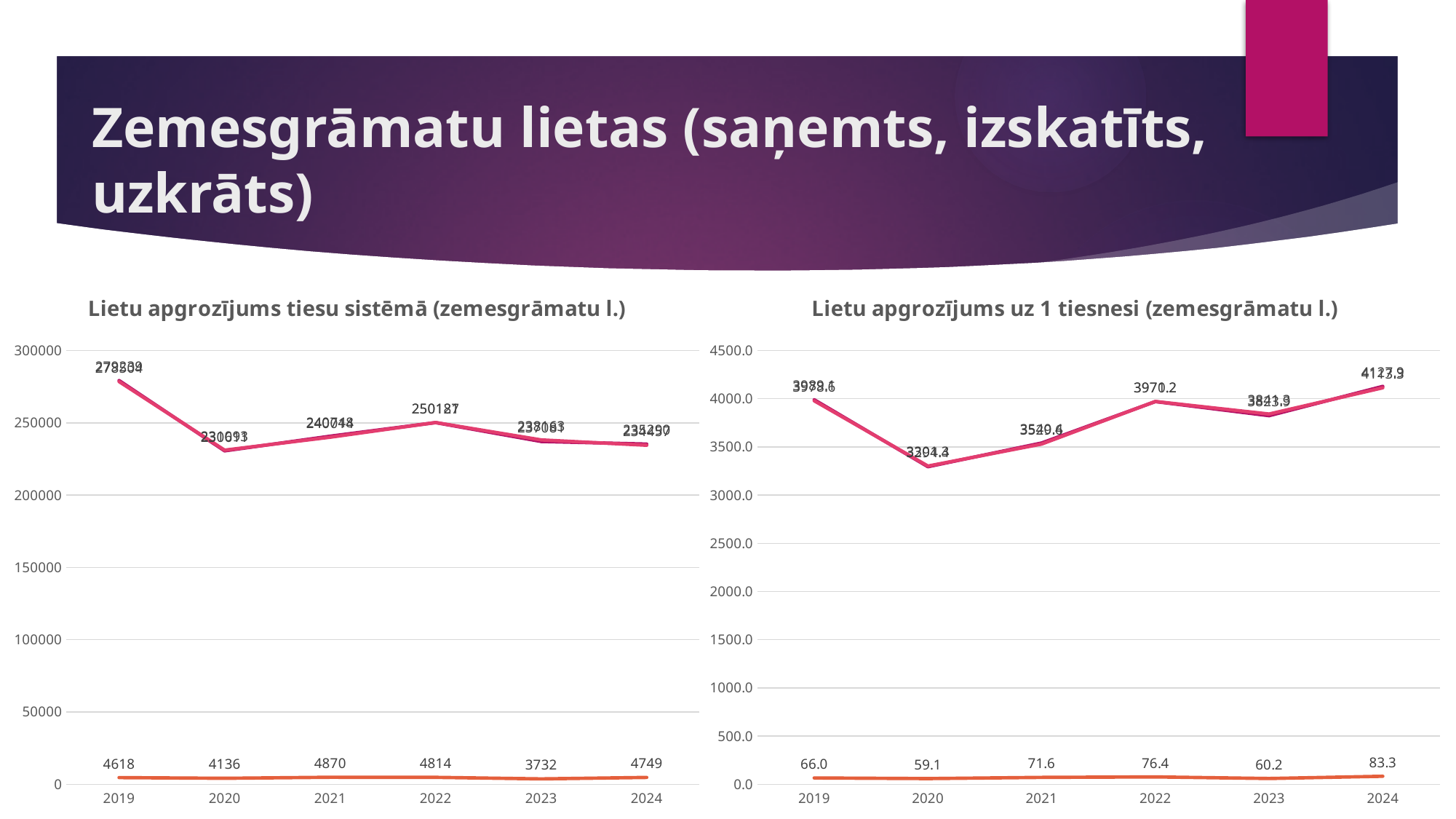
In the chart "Lietu apgrozījums uz 1 tiesnesi (zemesgrāmatu l.)", what is the difference between the orange line's values for 2024 and 2020? 24.2 In the chart "Lietu apgrozījums tiesu sistēmā (zemesgrāmatu l.)", what is the value of the lower orange line for 2019? 4618 What kind of chart is "Lietu apgrozījums tiesu sistēmā (zemesgrāmatu l.)"? line chart In the chart "Lietu apgrozījums tiesu sistēmā (zemesgrāmatu l.)", what is the difference between the orange line's values for 2021 and 2023? 1138 In the chart "Lietu apgrozījums uz 1 tiesnesi (zemesgrāmatu l.)", is the value of the upper pink line for 2020 greater or less than 3500.0? less In the chart "Lietu apgrozījums tiesu sistēmā (zemesgrāmatu l.)", what is the value of the lower orange line for 2023? 3732 In the chart "Lietu apgrozījums uz 1 tiesnesi (zemesgrāmatu l.)", what is the value of the lower orange line for 2024? 83.3 In the chart "Lietu apgrozījums tiesu sistēmā (zemesgrāmatu l.)", is the value of the upper pink line for 2019 greater or less than 250000? greater In the chart "Lietu apgrozījums uz 1 tiesnesi (zemesgrāmatu l.)", in which year does the lower orange line have its lowest value? 2020 How many years are shown on the x axis of the chart "Lietu apgrozījums tiesu sistēmā (zemesgrāmatu l.)"? 6 In the chart "Lietu apgrozījums tiesu sistēmā (zemesgrāmatu l.)", in which year does the lower orange line have its lowest value? 2023 In the chart "Lietu apgrozījums tiesu sistēmā (zemesgrāmatu l.)", in which year does the lower orange line reach its highest value? 2021